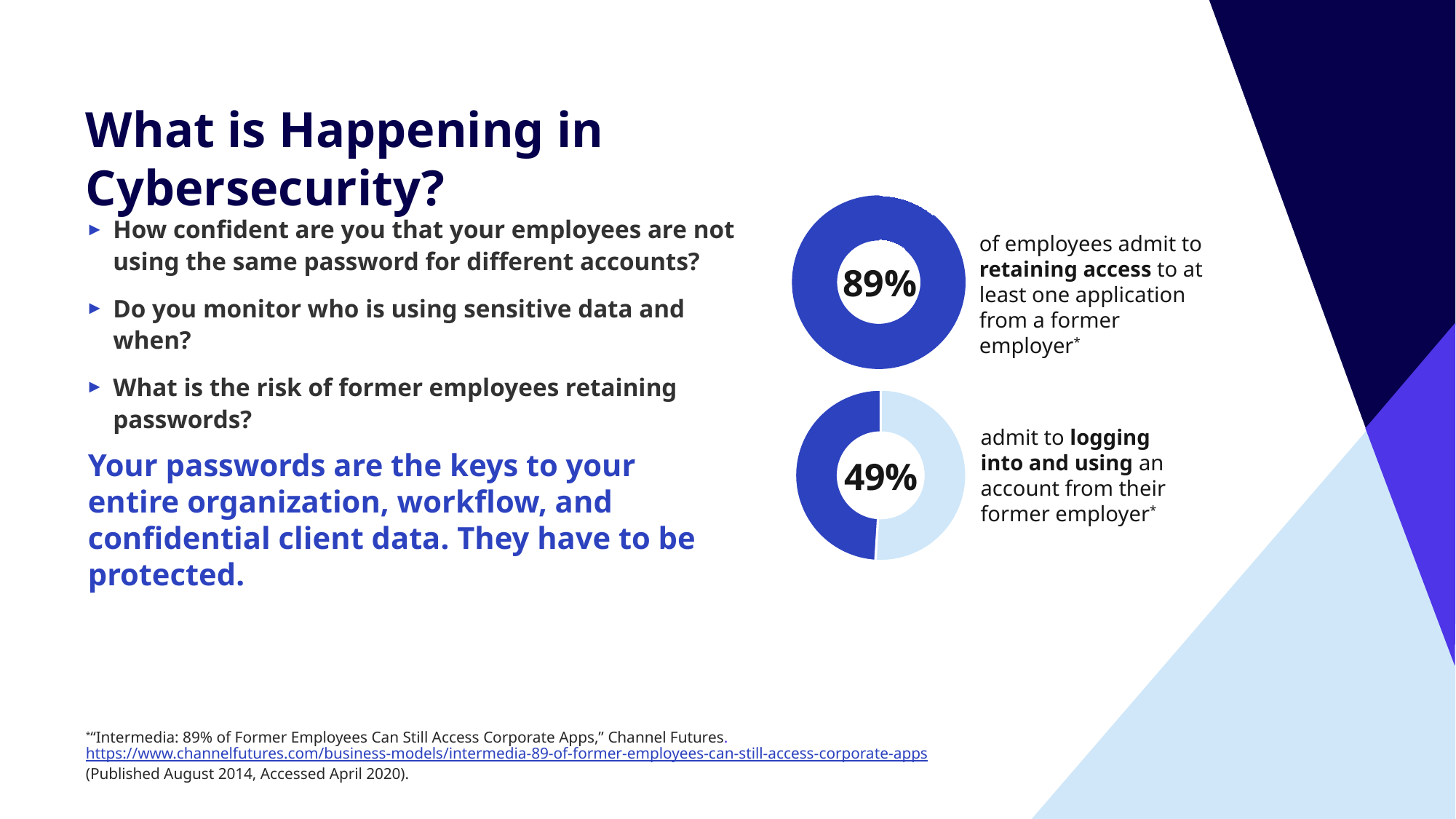
What percentage is shown in the centre of the top donut chart? 89% What kind of chart is used to show the 89% and 49% figures? Donut (pie) chart What share of employees admit to retaining access to at least one application from a former employer? 89% In the bottom donut chart, what share does the dark blue slice represent? 49% What percentage is shown in the centre of the bottom donut chart? 49% In the bottom donut chart, what share does the light blue slice represent? 51% What colour is the filled portion of the top donut chart? Blue Which is larger: the share admitting to retaining access (top chart) or the share admitting to logging into and using an account (bottom chart)? Retaining access (89%) What is the difference in percentage points between the top chart's value (89%) and the bottom chart's value (49%)? 40 percentage points How many donut charts are on the slide? 2 What share of employees admit to logging into and using an account from their former employer? 49% Which chart is positioned above the other on the slide: the 89% chart or the 49% chart? The 89% chart